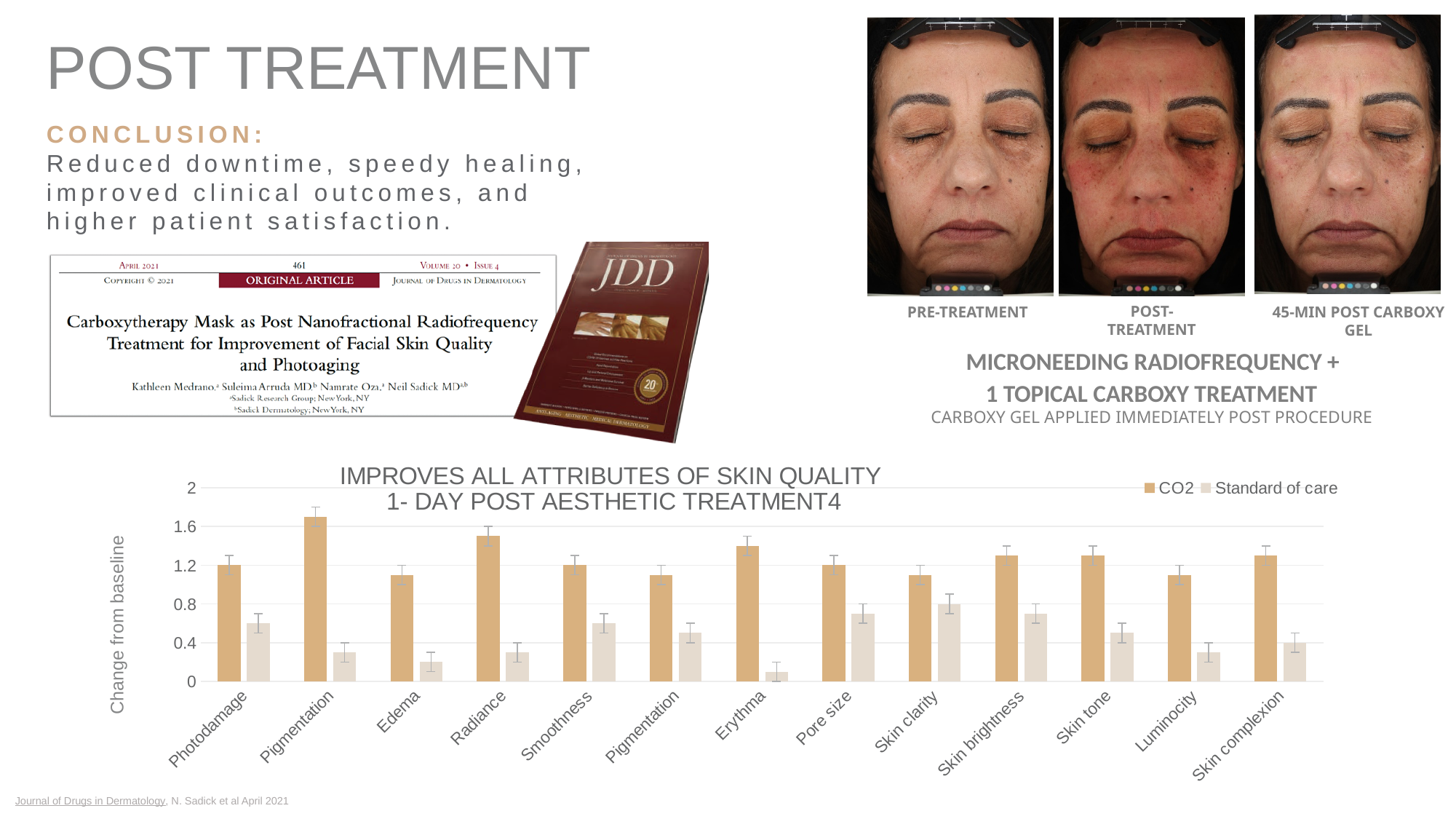
Is the CO2 value for Pigmentation (the second category) greater or less than 1.6? greater Is the Standard of care value for Erythma greater or less than 0.4? less Is the Standard of care value for Pore size greater or less than 0.4? greater How many series does the legend of the bar chart list? 2 For Photodamage, which series has the larger value, CO2 or Standard of care? CO2 What is the label on the y axis of the bar chart? Change from baseline How many skin-quality attributes (categories) are shown on the x axis of the bar chart? 13 Which has the larger Standard of care value, Photodamage or Edema? Photodamage What kind of chart is shown at the bottom of the slide? Bar chart Which category has the highest CO2 value in the bar chart? Pigmentation Which category has the lowest Standard of care value in the bar chart? Erythma